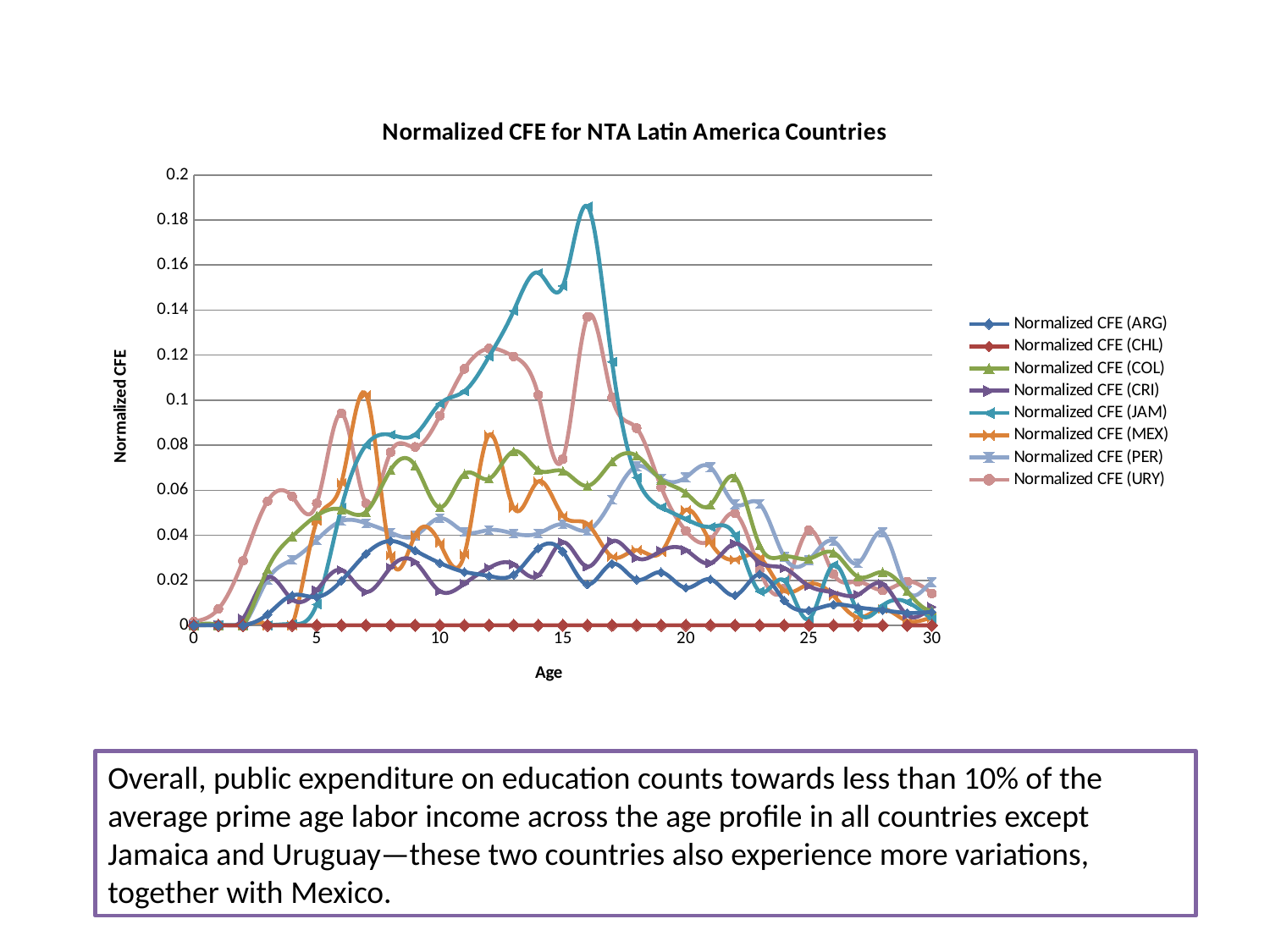
Which series reaches the highest value on the chart? Normalized CFE (JAM) What kind of chart is shown on the slide? line chart At age 16, which is larger: Normalized CFE (JAM) or Normalized CFE (URY)? Normalized CFE (JAM) What is the label of the x axis? Age Which series stays lowest across the whole age range? Normalized CFE (CHL) At age 7, which is larger: Normalized CFE (MEX) or Normalized CFE (ARG)? Normalized CFE (MEX) How many series does the legend list? 8 Is the value for Normalized CFE (CHL) at age 15 greater or less than 0.02? less Does the Normalized CFE (JAM) series rise or fall between age 16 and age 25? fall What is the title of the chart? Normalized CFE for NTA Latin America Countries Is the value for Normalized CFE (JAM) at age 16 greater or less than 0.16? greater Is the value for Normalized CFE (URY) at age 16 greater or less than 0.12? greater